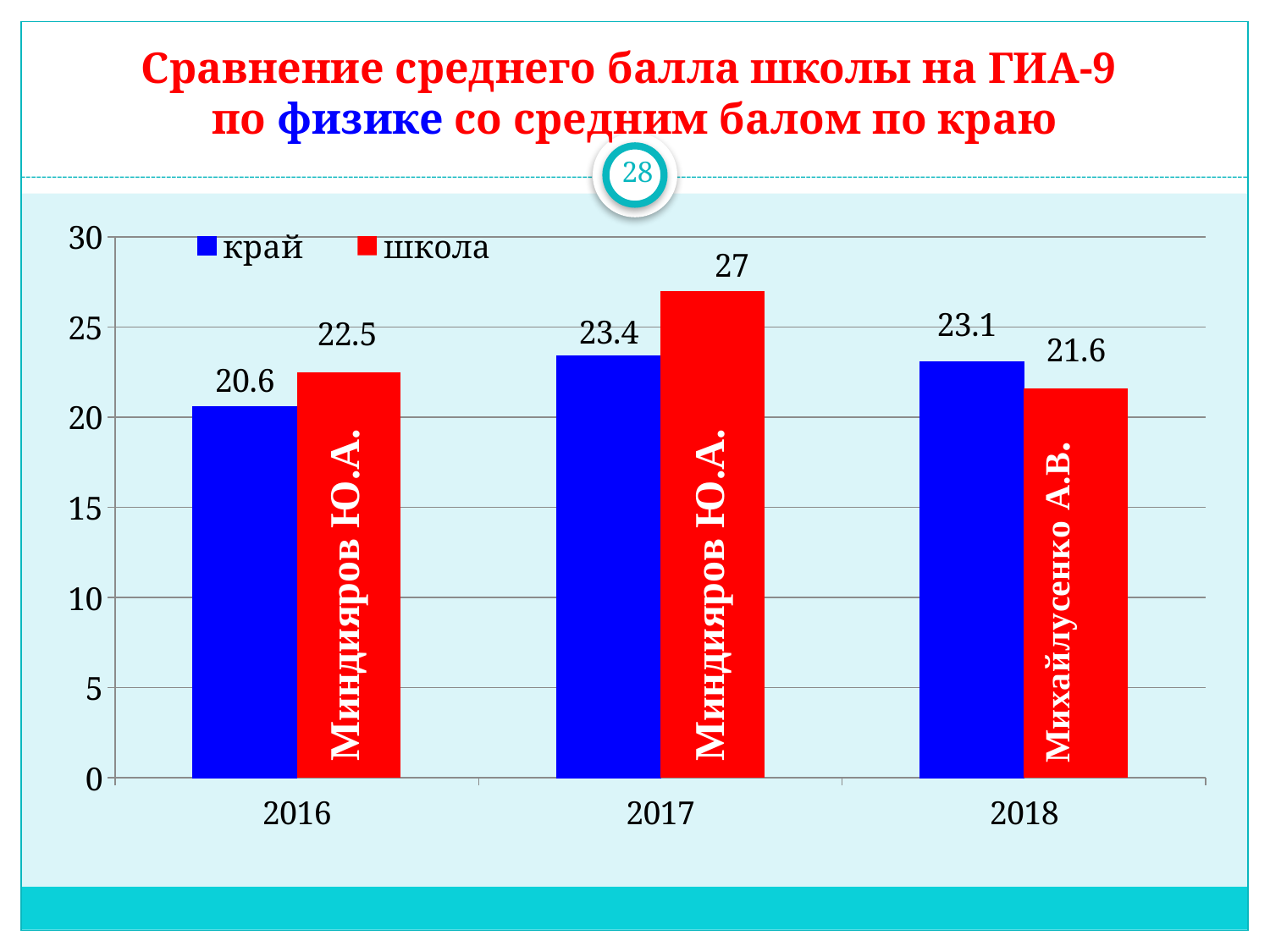
How many years are shown on the x axis? 3 How many series does the legend list? 2 What is the value for школа in 2017? 27 In which year is the край value lowest? 2016 What is the difference between the школа and край values in 2017? 3.6 What is the value for школа in 2018? 21.6 Is the value for школа in 2017 greater or less than 25? greater What is the value for край in 2016? 20.6 In which year is the школа value highest? 2017 What is the value for край in 2018? 23.1 What kind of chart is shown on the slide? bar chart In 2018, which is larger: край or школа? край